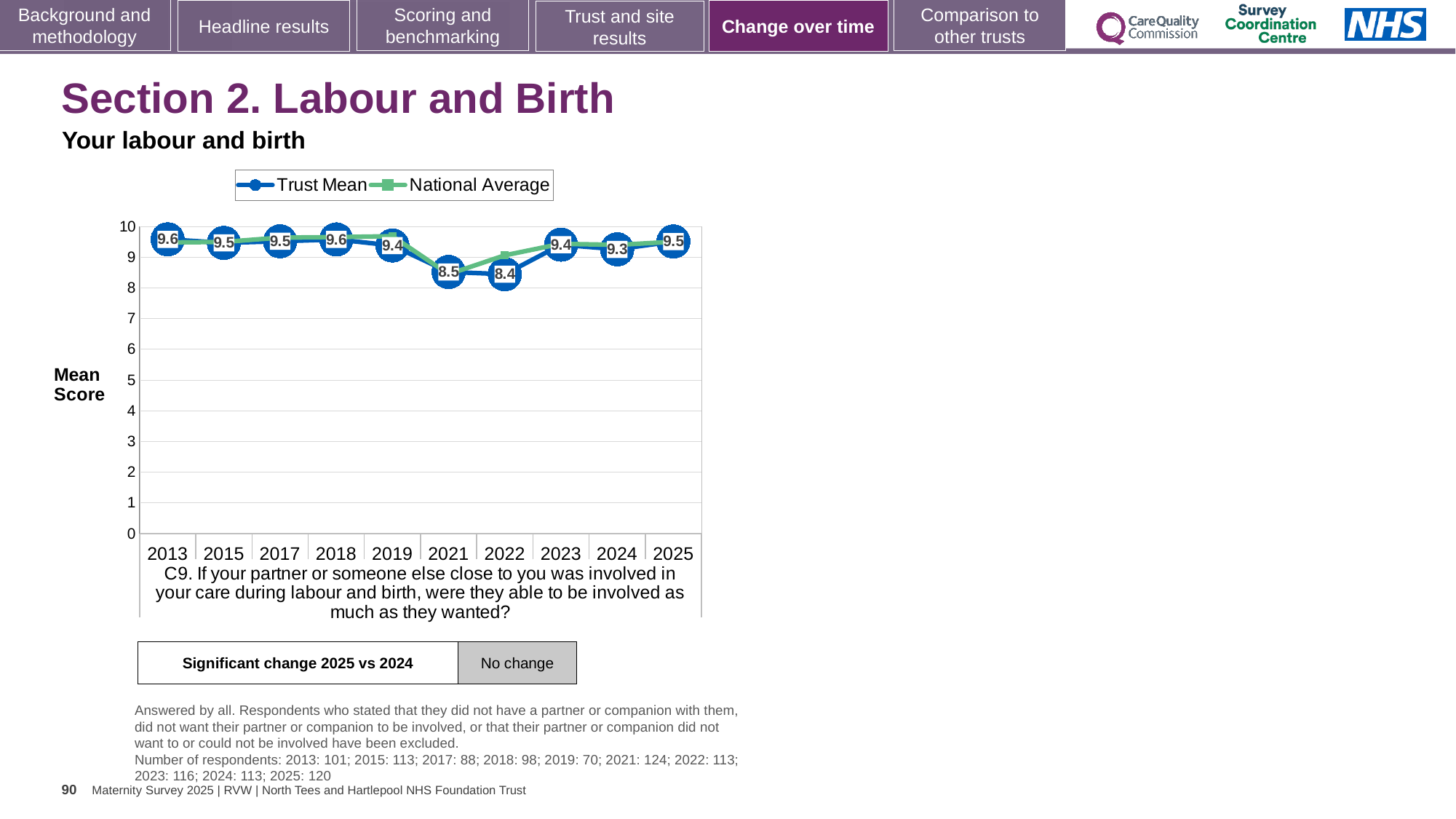
What is the Trust Mean for 2022? 8.4 What is the Trust Mean for 2024? 9.3 What is the difference between the Trust Mean in 2018 and in 2022? 1.2 Which year has the lowest Trust Mean? 2022 How many years are shown on the x axis? 10 How many series does the legend list? 2 What is the Trust Mean for 2013? 9.6 Is the Trust Mean for 2021 greater or less than 9? less What kind of chart is shown? line chart Does the Trust Mean rise or fall from 2022 to 2023? rise Which is larger, the Trust Mean for 2021 or for 2023? 2023 What is the Trust Mean for 2025? 9.5